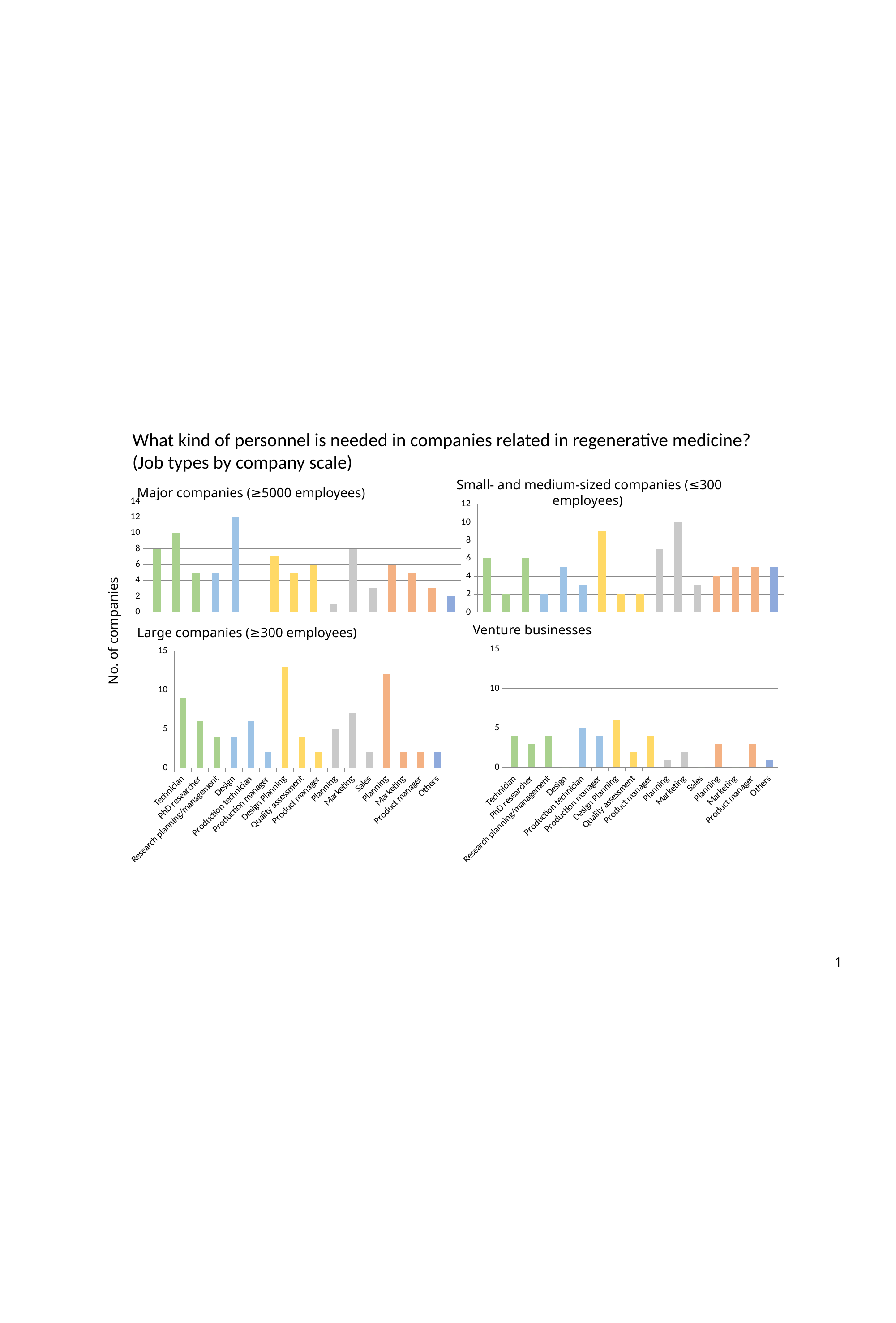
What kind of chart is the 'Large companies (≥300 employees)' chart? bar chart What is the label on the vertical axis shared by the charts? No. of companies In the 'Venture businesses' chart, which is larger: Design Planning or PhD researcher? Design Planning In the 'Major companies (≥5000 employees)' chart, what value does the tallest bar reach? 12 In the 'Large companies (≥300 employees)' chart, is the value for Technician greater or less than 5? greater In the 'Large companies (≥300 employees)' chart, is the value for Design Planning greater or less than 10? greater How many charts are shown on the slide? 4 In the 'Venture businesses' chart, which job type has the highest value? Design Planning In the 'Venture businesses' chart, what is the value for Production technician? 5 In the 'Large companies (≥300 employees)' chart, which is larger: Technician or Production manager? Technician In the 'Small- and medium-sized companies (≤300 employees)' chart, what value does the tallest bar reach? 10 In the 'Venture businesses' chart, is the value for Quality assessment greater or less than 5? less